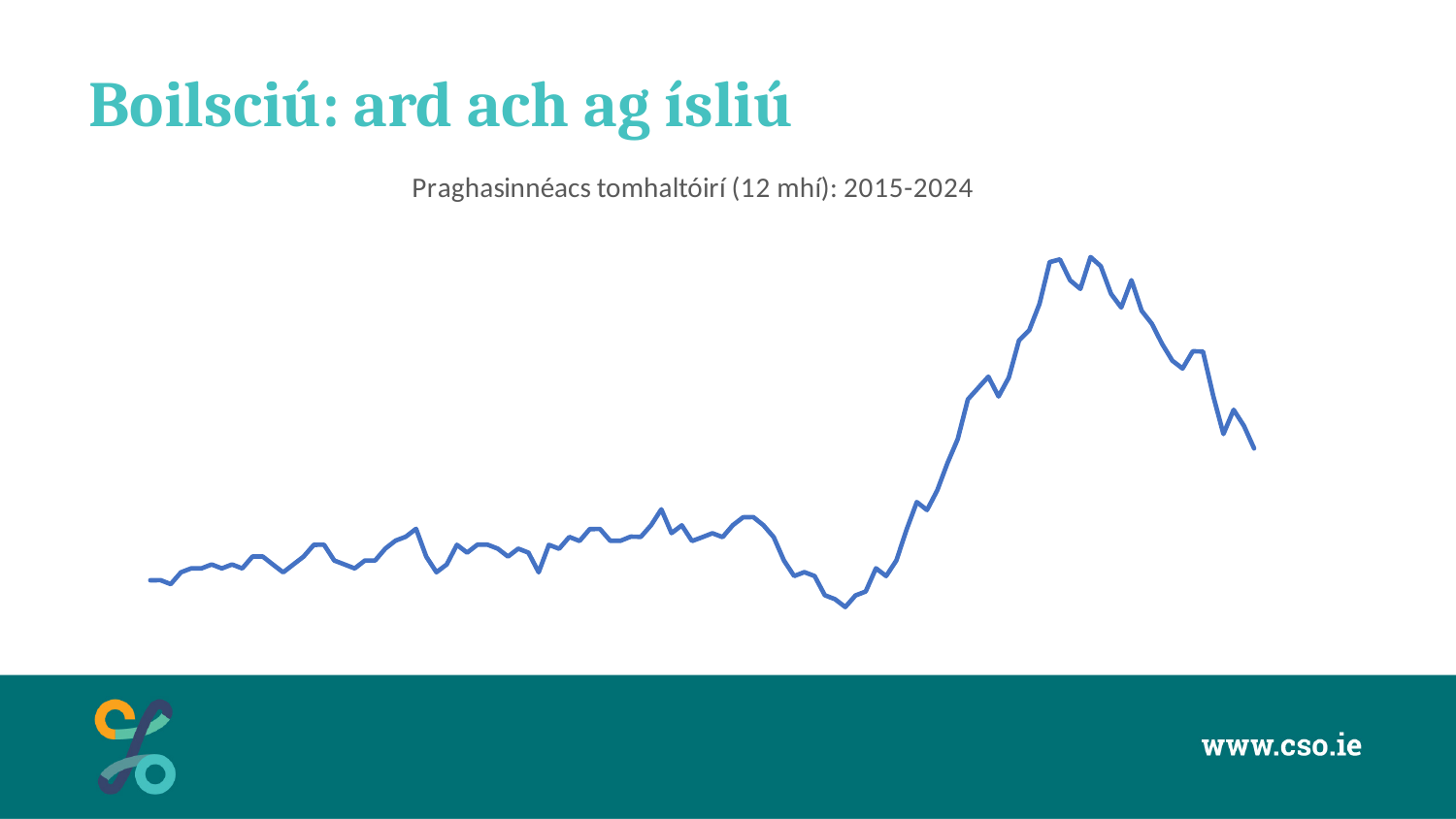
What is the title of the chart on the slide? Praghasinnéacs tomhaltóirí (12 mhí): 2015-2024 Is the line at the right end of the chart higher or lower than at the left end? higher What colour is the line on the chart? blue Does the line rise or fall over the final portion of the chart, after its peak? fall How many lines are plotted on the chart? 1 What kind of chart is shown on the slide? line chart